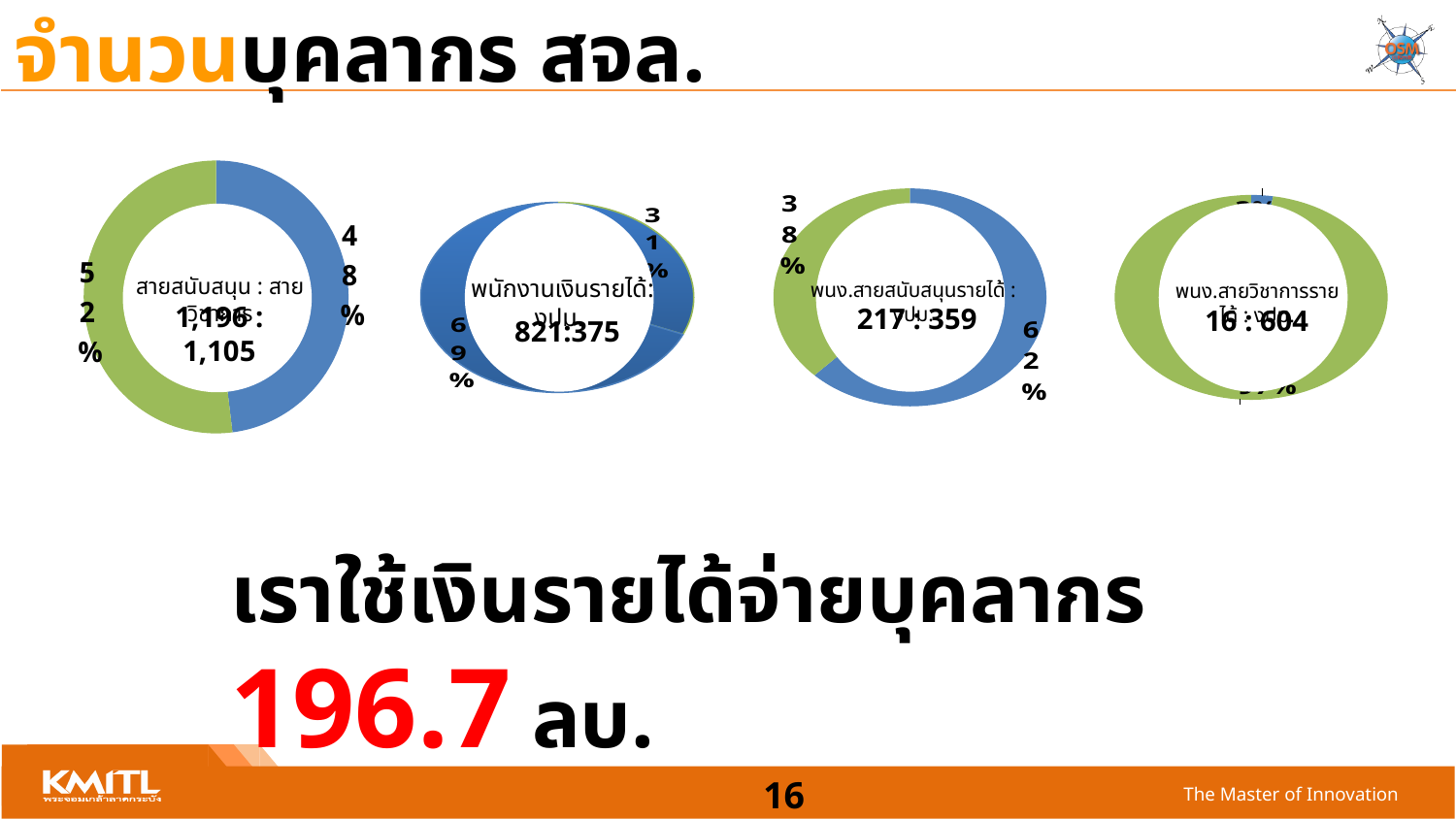
In the third chart from the left (พนง.สายสนับสนุนรายได้), which slice is larger, the green one or the blue one? Blue In the leftmost chart (สายสนับสนุน : สายวิชาการ), what percentage is shown for the green slice? 52% What kind of chart is used for the leftmost chart on the slide? Doughnut chart In the third chart from the left (พนง.สายสนับสนุนรายได้), what is the difference in percentage points between the blue slice and the green slice? 24 In the third chart from the left (พนง.สายสนับสนุนรายได้), what percentage is shown for the green slice? 38% How many slices does the leftmost doughnut chart have? 2 In the leftmost chart (สายสนับสนุน : สายวิชาการ), what percentage is shown for the blue slice? 48% How many doughnut charts are shown on the slide? 4 In the leftmost chart (สายสนับสนุน : สายวิชาการ), which slice is larger, the green one or the blue one? Green In the third chart from the left (พนง.สายสนับสนุนรายได้), what percentage is shown for the blue slice? 62% In the second chart from the left (พนักงานเงินรายได้ : งบปม.), what is the larger of the two percentages shown? 69% In the leftmost chart (สายสนับสนุน : สายวิชาการ), what is the difference in percentage points between the green slice and the blue slice? 4